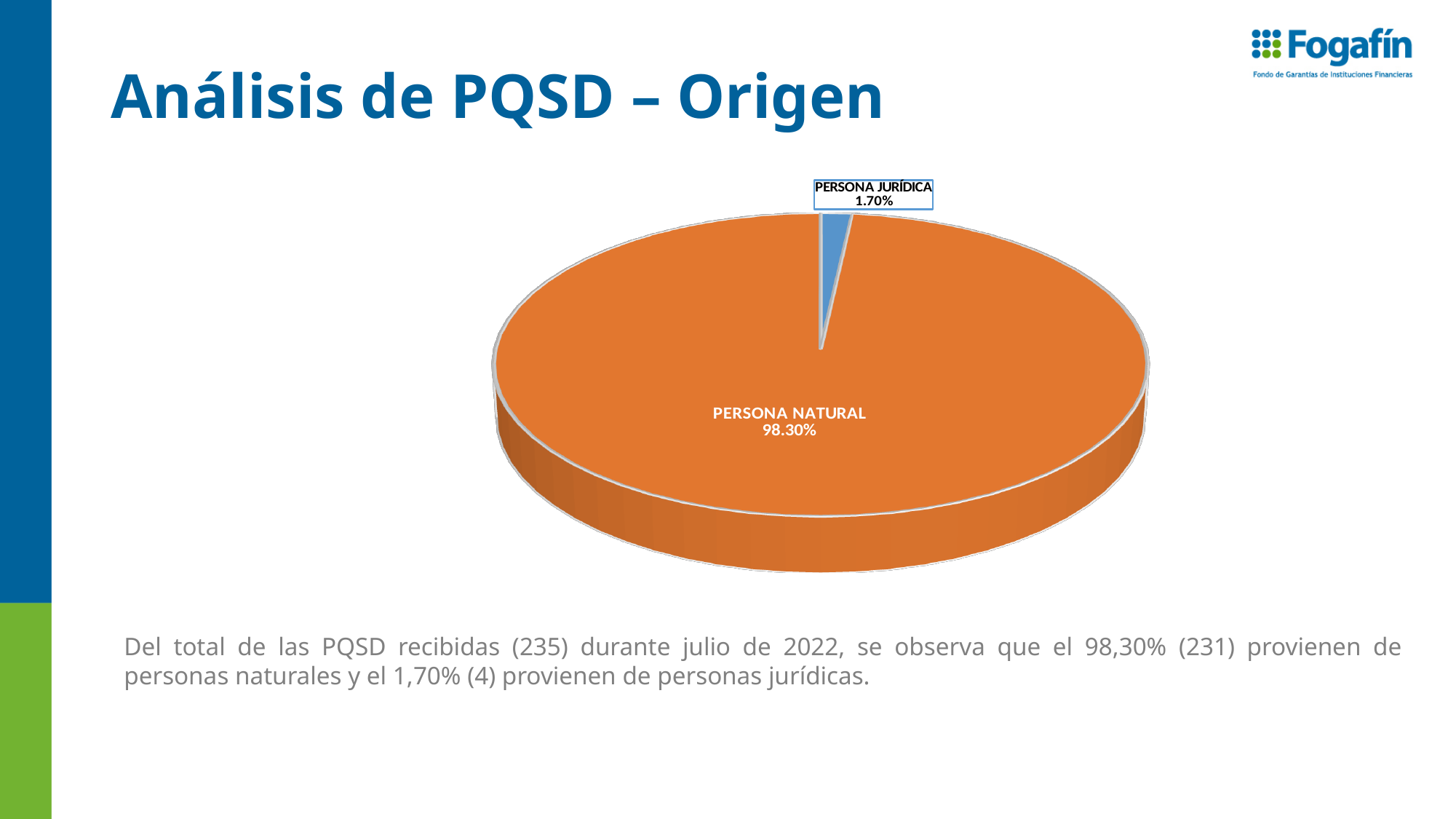
Which is larger, the PERSONA NATURAL slice or the PERSONA JURÍDICA slice? PERSONA NATURAL What share of the pie does PERSONA NATURAL represent? 98.30% How many slices does the pie chart have? 2 What is the difference in percentage points between the PERSONA NATURAL and PERSONA JURÍDICA slices? 96.60% What colour is the PERSONA JURÍDICA slice? Blue Which slice of the pie is the largest? PERSONA NATURAL Which slice of the pie is the smallest? PERSONA JURÍDICA What share of the pie does PERSONA JURÍDICA represent? 1.70% What colour is the PERSONA NATURAL slice? Orange What kind of chart is shown on the slide? Pie chart